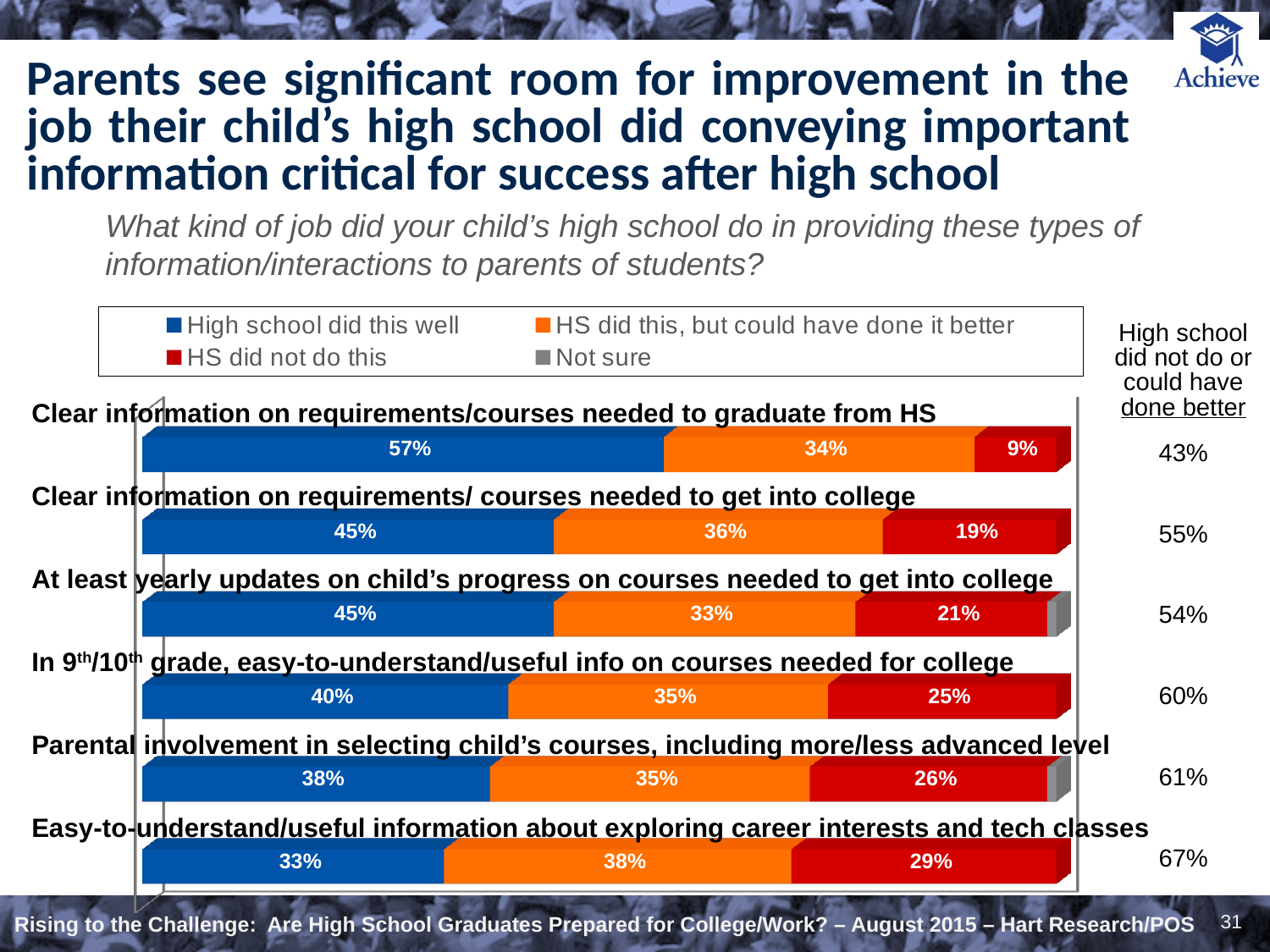
Is the 'High school did this well' percentage larger for clear information on requirements to get into college or for in 9th/10th grade info on courses needed for college? Clear information on requirements/ courses needed to get into college Which colour represents 'HS did not do this' in the legend? Red What is the combined 'did not do or could have done better' percentage shown for at least yearly updates on child's progress on courses needed to get into college? 54% What is the difference between the 'HS did not do this' percentages for career interests/tech classes information and for requirements needed to graduate from HS? 20% How many items (bars) are shown in the chart? 6 For parental involvement in selecting child's courses, what share said the HS did this but could have done it better? 35% Which item has the lowest percentage for 'High school did this well'? Easy-to-understand/useful information about exploring career interests and tech classes Which item has the highest percentage for 'High school did this well'? Clear information on requirements/courses needed to graduate from HS What percentage said the HS did not do this for easy-to-understand/useful information about exploring career interests and tech classes? 29% How many series does the legend list? 4 What percentage of parents said the high school did well on providing clear information on requirements/courses needed to graduate from HS? 57% What kind of chart is shown on the slide? Stacked bar chart